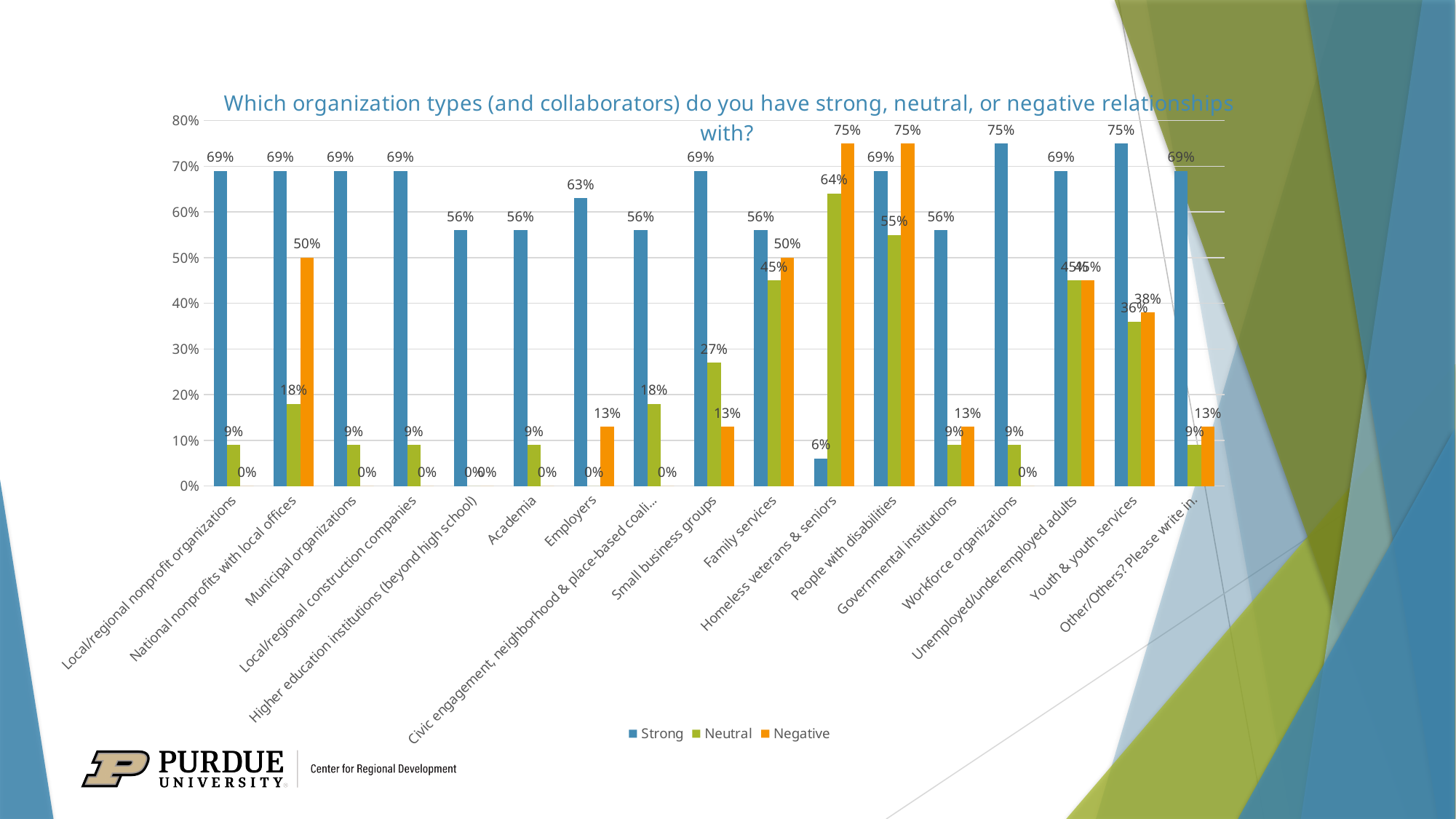
How many organization types are shown on the x axis? 17 What is the Strong value for Employers? 63% Which category has the lowest Strong value? Homeless veterans & seniors How many series does the legend list? 3 Which has a higher Strong value: Workforce organizations or Governmental institutions? Workforce organizations Which category has the highest Neutral value? Homeless veterans & seniors What is the Neutral value for Homeless veterans & seniors? 64% What kind of chart is shown on the slide? Bar chart Is the Neutral value for Small business groups greater or less than 30%? less What are the three series named in the legend? Strong, Neutral, Negative What is the Negative value for National nonprofits with local offices? 50% For Homeless veterans & seniors, how much higher is the Negative value than the Strong value? 69 percentage points